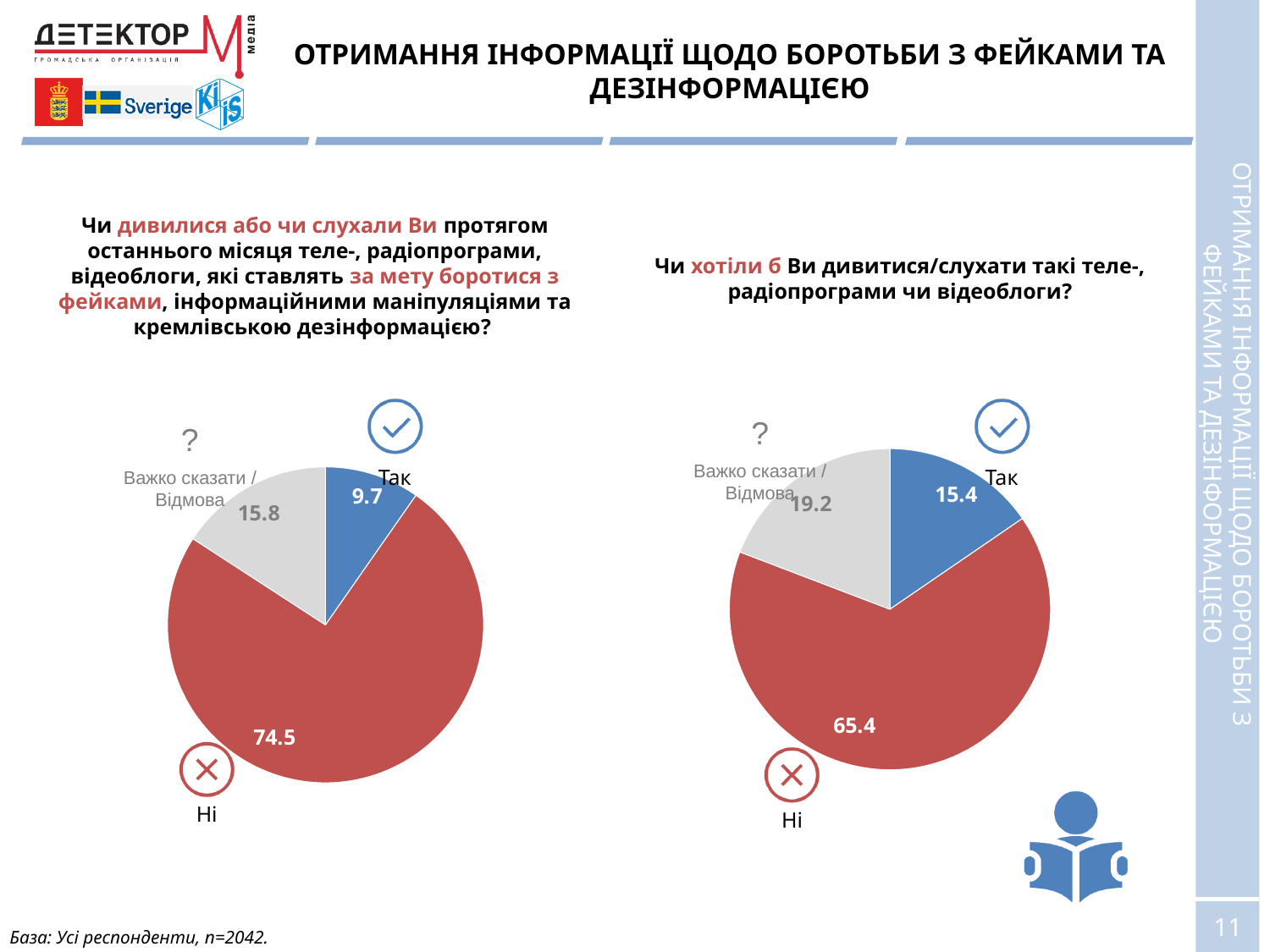
In the left pie chart (about watching or listening in the last month), what is the value for "Так"? 9.7 In the left pie chart, what is the difference between the values for "Ні" and "Так"? 64.8 In the left pie chart (about watching or listening in the last month), what is the value for "Важко сказати / Відмова"? 15.8 What type of chart is used on the left side of the slide? Pie chart Which is larger: the "Так" value in the left pie chart or the "Так" value in the right pie chart? The right pie chart (15.4) In the right pie chart (about wanting to watch/listen), what is the value for "Так"? 15.4 In the left pie chart, which category has the largest slice? Ні In the left pie chart (about watching or listening in the last month), what is the value for "Ні"? 74.5 In the right pie chart (about wanting to watch/listen), what is the value for "Важко сказати / Відмова"? 19.2 How many slices does the right pie chart have? 3 In the right pie chart, which category has the smallest slice? Так In the right pie chart (about wanting to watch/listen), what is the value for "Ні"? 65.4